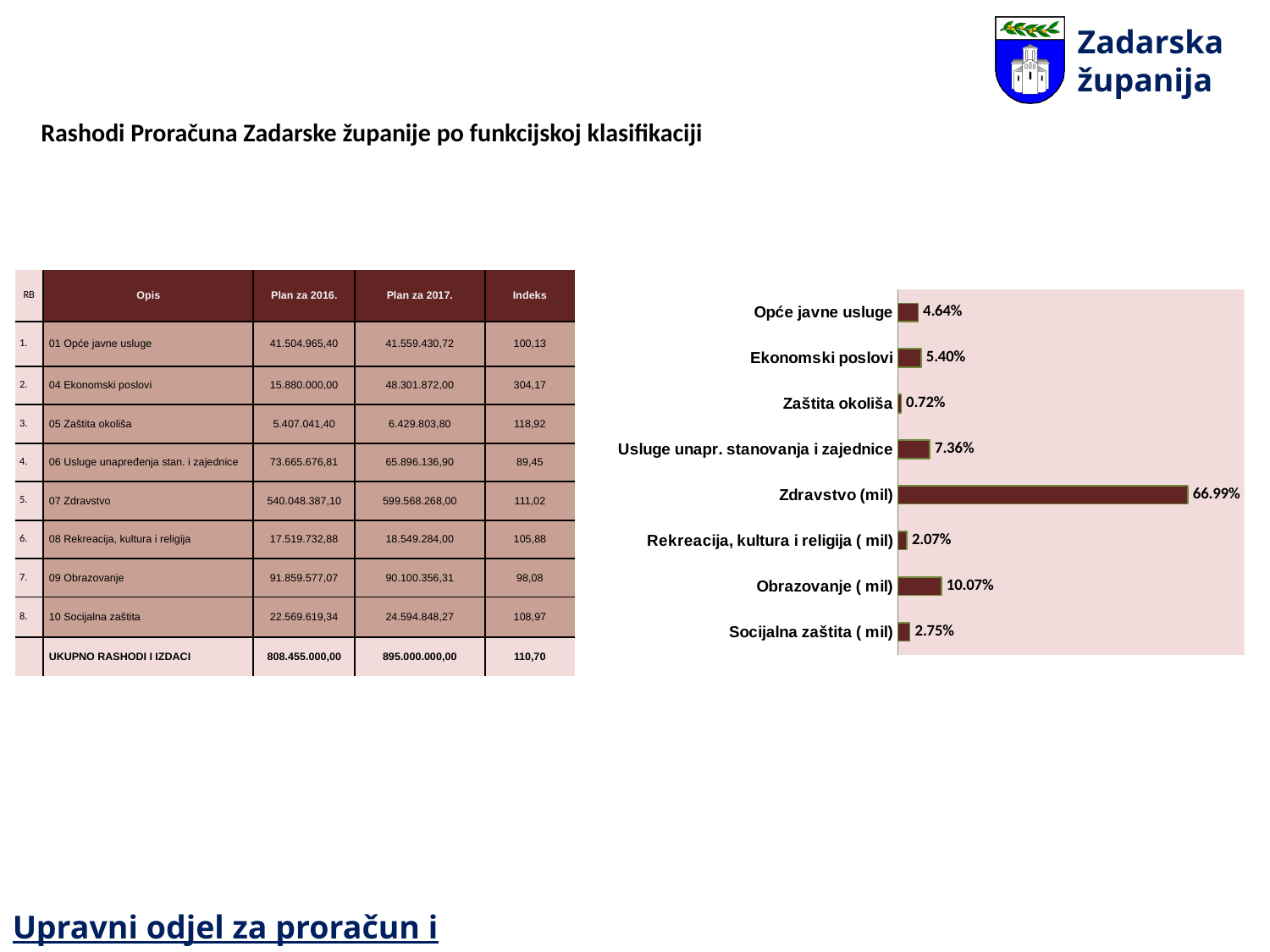
What value is shown for Usluge unapr. stanovanja i zajednice in the bar chart? 7.36% What value is shown for Zdravstvo (mil) in the bar chart? 66.99% Which has the larger value in the bar chart, Socijalna zaštita ( mil) or Rekreacija, kultura i religija ( mil)? Socijalna zaštita ( mil) What kind of chart is shown on the right side of the slide? Bar chart What is the difference between the values for Obrazovanje ( mil) and Ekonomski poslovi in the bar chart? 4.67% Which category has the highest value in the bar chart? Zdravstvo (mil) What value is shown for Obrazovanje ( mil) in the bar chart? 10.07% What is the difference between the values for Usluge unapr. stanovanja i zajednice and Opće javne usluge in the bar chart? 2.72% Which category has the lowest value in the bar chart? Zaštita okoliša How many categories are shown in the bar chart? 8 What value is shown for Zaštita okoliša in the bar chart? 0.72% Which has the larger value in the bar chart, Ekonomski poslovi or Opće javne usluge? Ekonomski poslovi